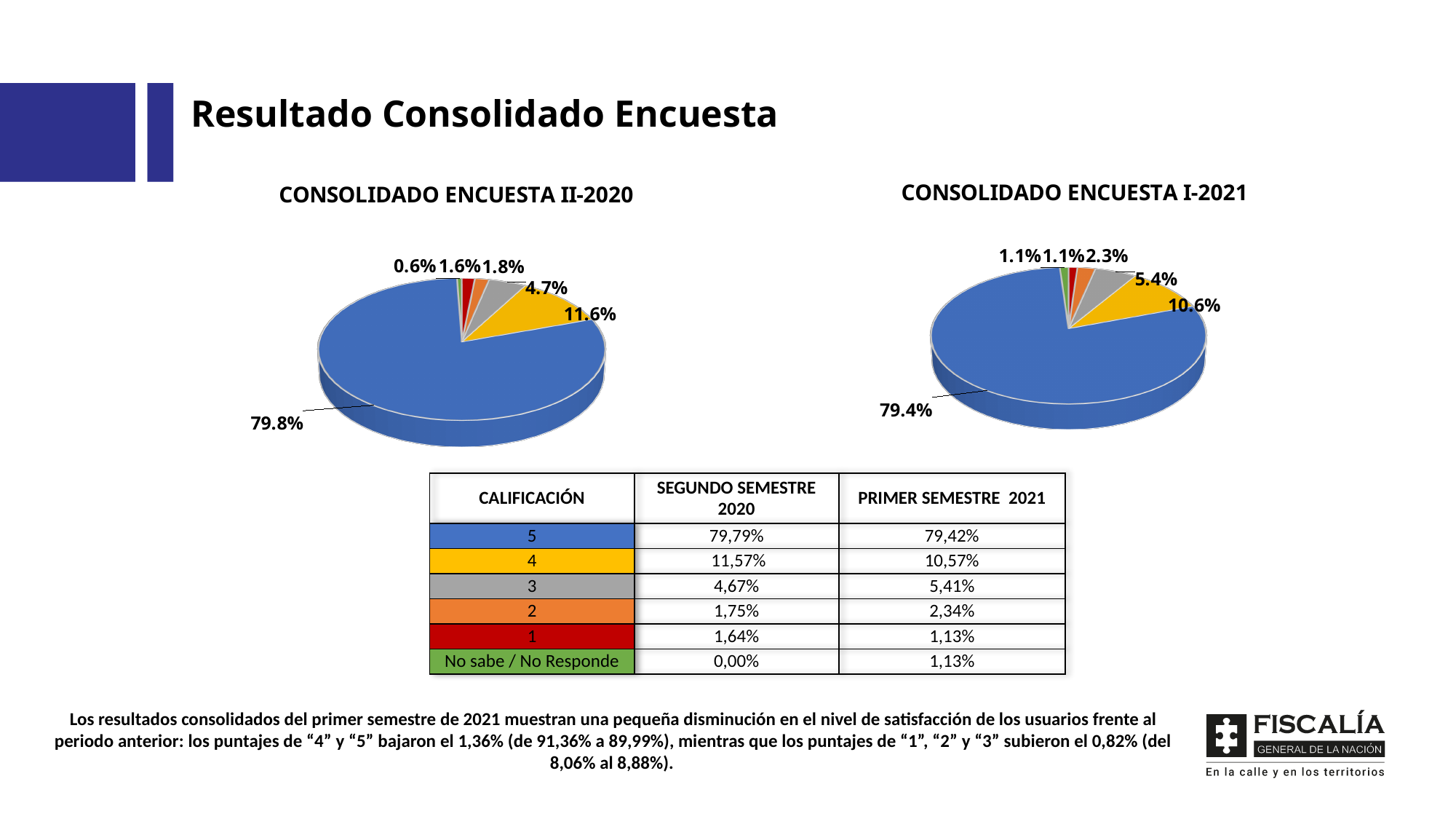
In the CONSOLIDADO ENCUESTA I-2021 chart, what is the value of the largest slice? 79.4% What kind of chart is the CONSOLIDADO ENCUESTA II-2020 chart? pie chart In the CONSOLIDADO ENCUESTA I-2021 chart, what is the value of the orange slice? 2.3% In the CONSOLIDADO ENCUESTA I-2021 chart, what is the value of the yellow slice? 10.6% What is the title of the pie chart on the right side of the slide? CONSOLIDADO ENCUESTA I-2021 In the CONSOLIDADO ENCUESTA II-2020 chart, what is the difference between the blue slice (79.8%) and the yellow slice (11.6%)? 68.2% How many slices are labelled in the CONSOLIDADO ENCUESTA I-2021 chart? 6 In the CONSOLIDADO ENCUESTA II-2020 chart, what is the value of the smallest slice? 0.6% Which chart has the larger yellow slice, CONSOLIDADO ENCUESTA II-2020 or CONSOLIDADO ENCUESTA I-2021? CONSOLIDADO ENCUESTA II-2020 In the CONSOLIDADO ENCUESTA II-2020 chart, what is the value of the yellow slice? 11.6% In the CONSOLIDADO ENCUESTA II-2020 chart, what is the value of the largest slice? 79.8% In the CONSOLIDADO ENCUESTA I-2021 chart, what is the value of the gray slice? 5.4%